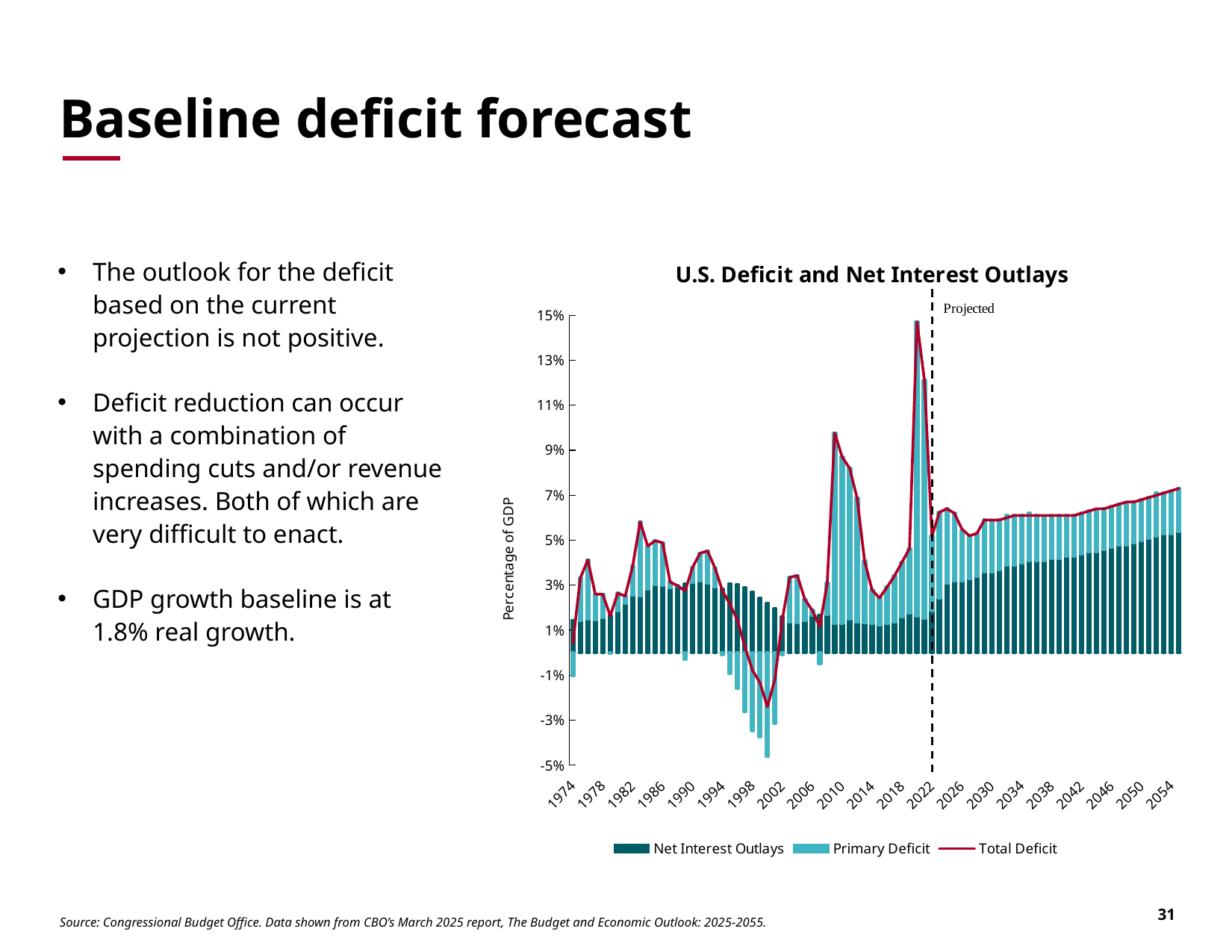
Is the Primary Deficit value for 1998 greater or less than -1%? less How many year labels are shown on the x axis of the chart? 21 What is the label on the vertical axis of the chart? Percentage of GDP Is the highest value of the Total Deficit line greater or less than 13%? greater Is the Total Deficit value for 2054 greater or less than 9%? less How many series does the legend of the U.S. Deficit and Net Interest Outlays chart list? 3 Which is larger, the Total Deficit value for 2010 or for 2014? 2010 Does the Total Deficit line generally rise or fall from 2030 to 2054? rise What kind of chart is shown on the slide? A combined bar and line chart (stacked bars with a line) What is the title of the chart on the slide? U.S. Deficit and Net Interest Outlays